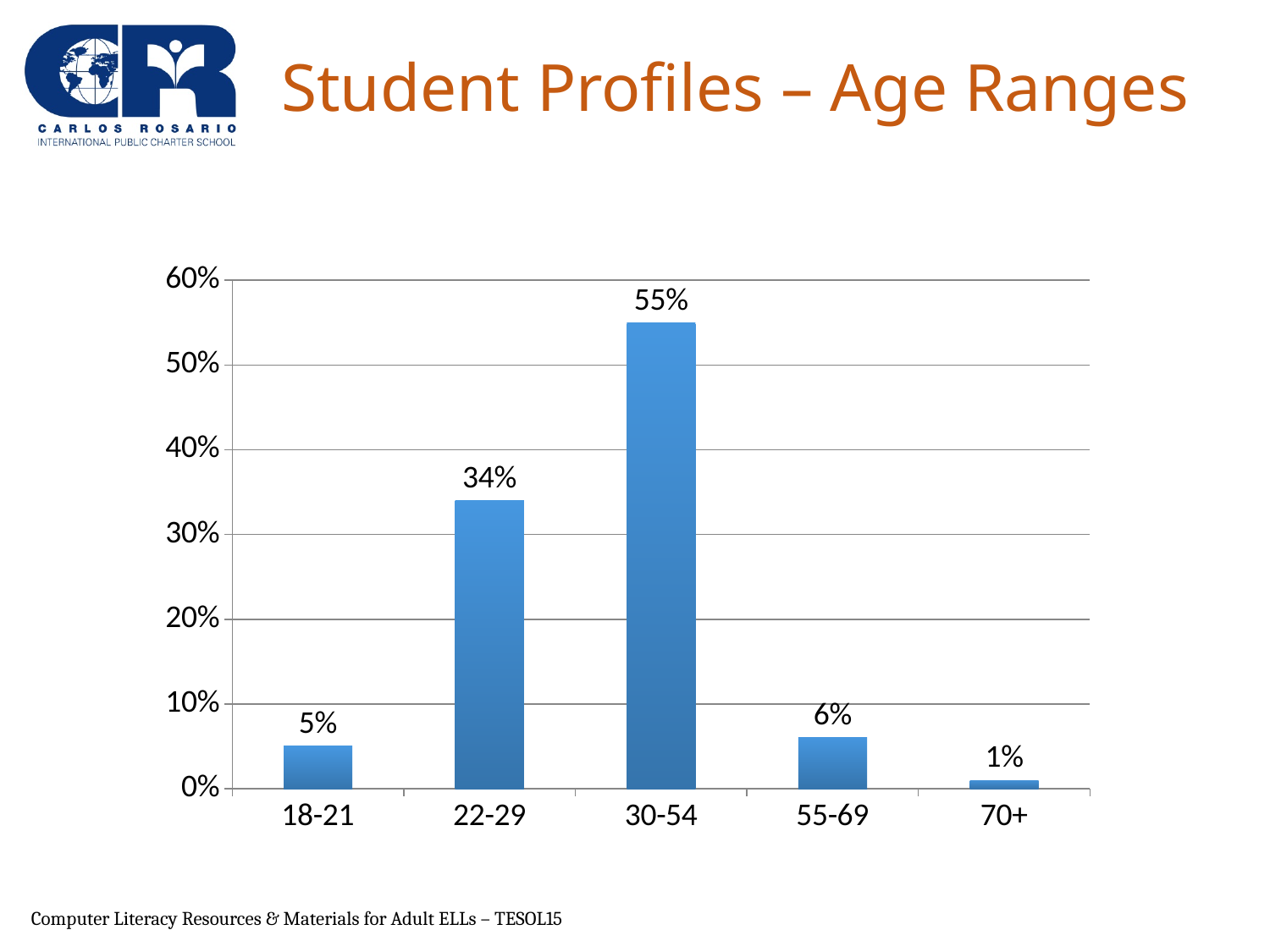
What percentage of students are in the 22-29 age range? 34% Which age range has a larger share of students, 18-21 or 55-69? 55-69 Which age range has the lowest percentage of students? 70+ How many age ranges are shown on the chart? 5 What percentage of students are in the 18-21 age range? 5% What is the title of the slide containing the chart? Student Profiles – Age Ranges Which age range has the highest percentage of students? 30-54 What kind of chart is shown on the slide? Bar chart What percentage of students are in the 30-54 age range? 55% What is the difference in percentage points between the 30-54 and 22-29 age ranges? 21 Is the value for the 22-29 age range greater or less than 30%? greater What percentage of students are aged 70+? 1%